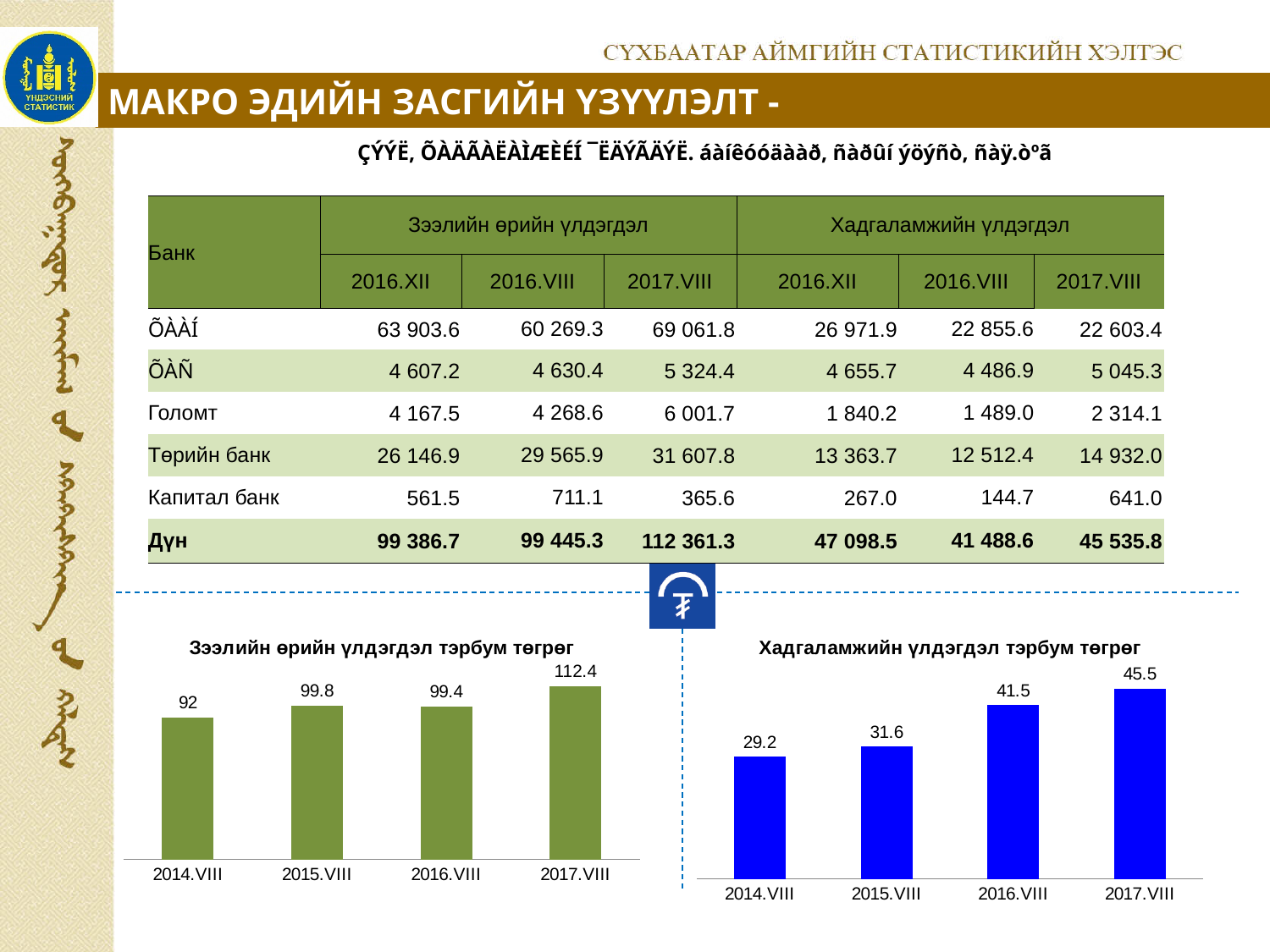
In the right chart (Хадгаламжийн үлдэгдэл тэрбум төгрөг), what is the value for 2016.VIII? 41.5 In the right chart (Хадгаламжийн үлдэгдэл тэрбум төгрөг), which period has the lowest value? 2014.VIII What colour are the bars in the right chart (Хадгаламжийн үлдэгдэл тэрбум төгрөг)? Blue In the left chart (Зээлийн өрийн үлдэгдэл тэрбум төгрөг), what is the value for 2014.VIII? 92 How many bars are in the right chart (Хадгаламжийн үлдэгдэл тэрбум төгрөг)? 4 In the right chart (Хадгаламжийн үлдэгдэл тэрбум төгрөг), do the values rise or fall from 2014.VIII to 2017.VIII? Rise What type of chart is the left chart (Зээлийн өрийн үлдэгдэл тэрбум төгрөг)? Bar chart In the left chart (Зээлийн өрийн үлдэгдэл тэрбум төгрөг), which period has the highest value? 2017.VIII In the left chart (Зээлийн өрийн үлдэгдэл тэрбум төгрөг), what is the difference between the values for 2017.VIII and 2016.VIII? 13 In the right chart (Хадгаламжийн үлдэгдэл тэрбум төгрөг), what is the difference between the values for 2017.VIII and 2014.VIII? 16.3 In the left chart (Зээлийн өрийн үлдэгдэл тэрбум төгрөг), which is larger: the value for 2015.VIII or 2014.VIII? 2015.VIII In the left chart (Зээлийн өрийн үлдэгдэл тэрбум төгрөг), what is the value for 2017.VIII? 112.4